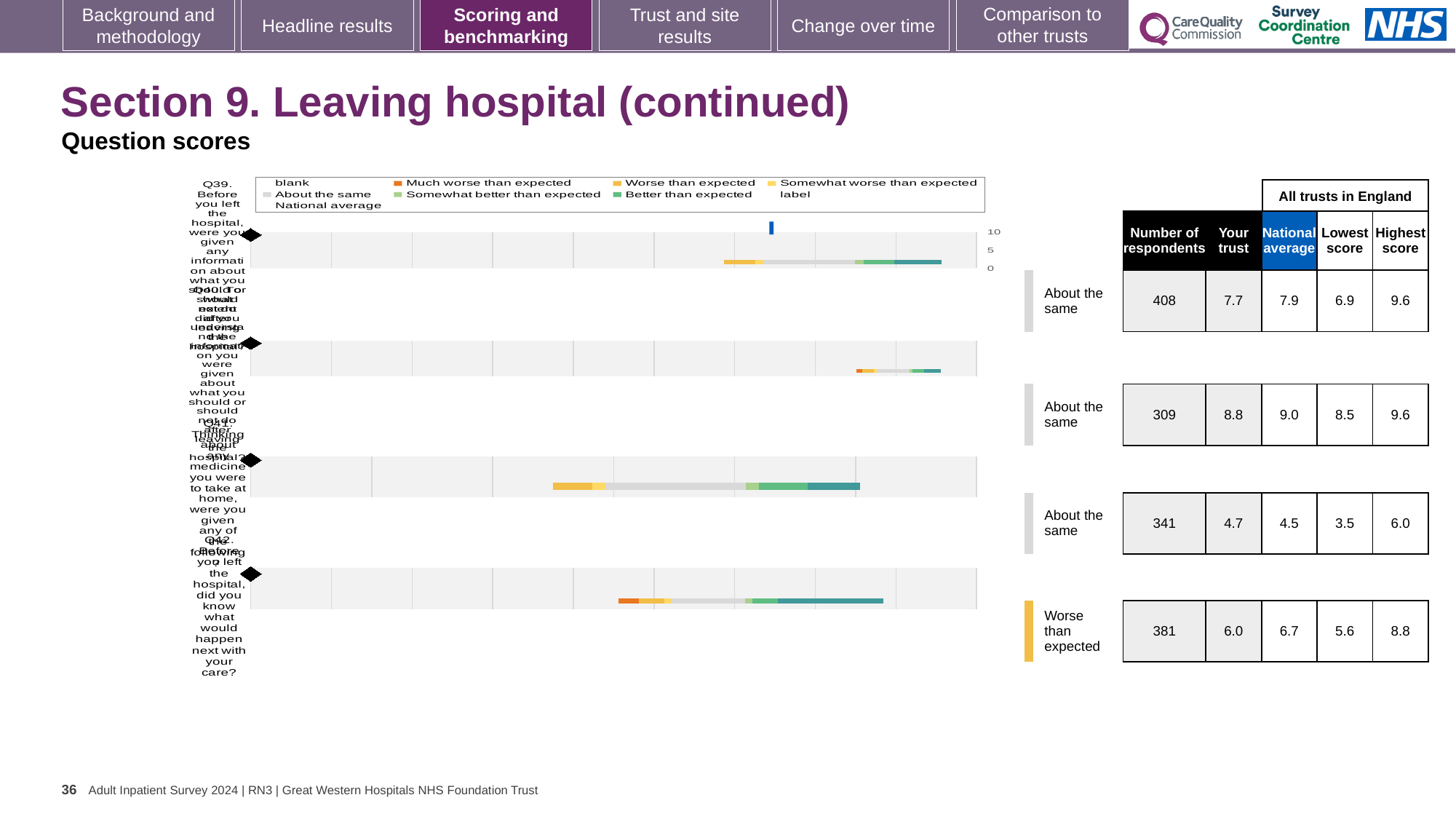
What kind of chart is shown on the slide? bar chart What is the 'Your trust' score for the first row (Q39)? 7.7 What is the national average for the first row (Q39)? 7.9 What is the difference between the national average and the 'Your trust' score for the first row (Q39)? 0.2 Which row has the lowest 'Your trust' score? the third row (4.7) How many question rows (bars) does the chart show? 4 For the last row (Q42), which is larger: the 'Your trust' score or the national average? national average Which question label appears at the top of the chart? Q39 What is the highest score across all trusts in England for the last row (Q42)? 8.8 What is the number of respondents for the last row (Q42)? 381 Which row has the highest 'Your trust' score? the second row (8.8) What benchmark category is shown for the last row (Q42)? Worse than expected